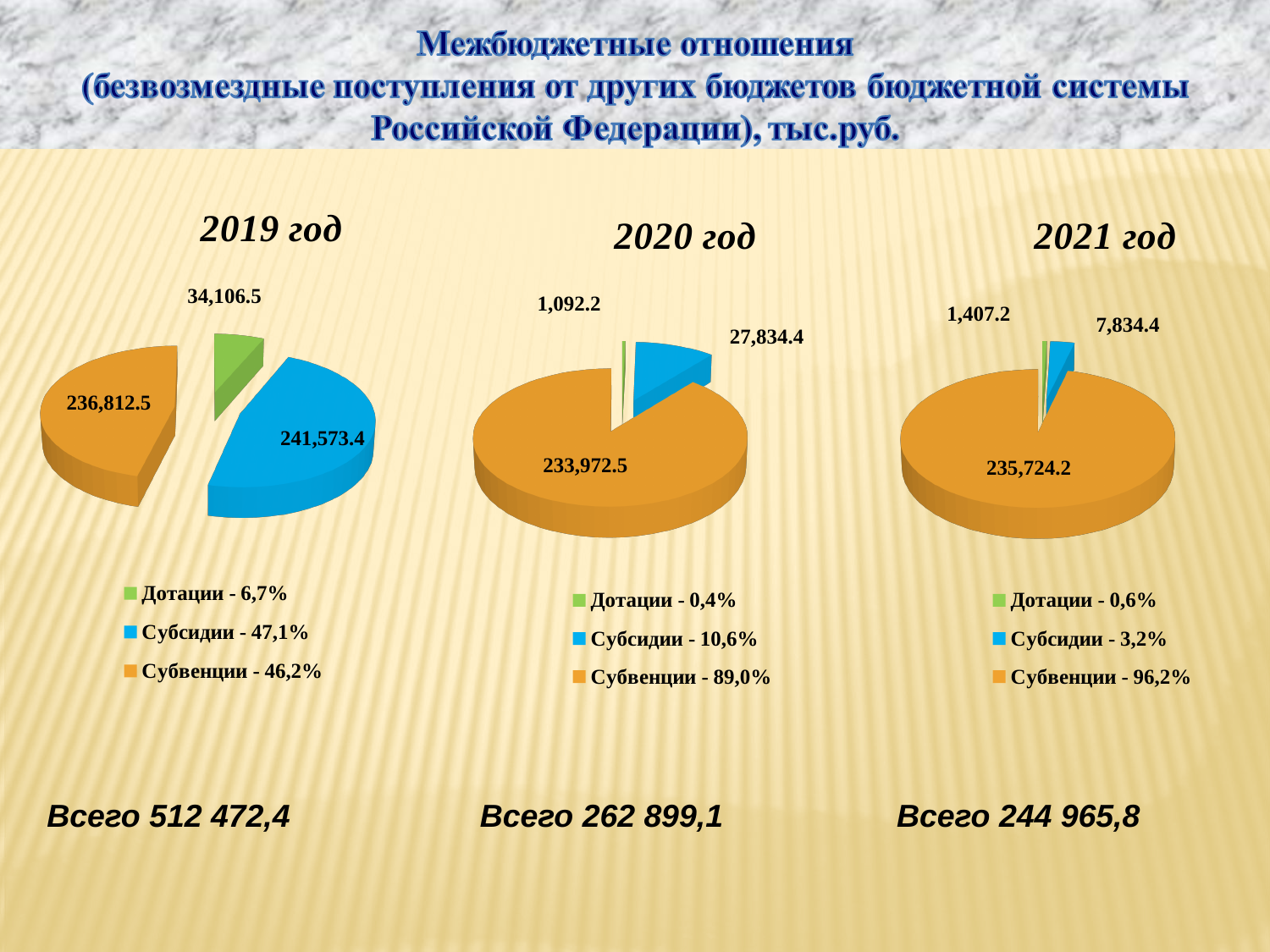
In the 2020 год chart, what share of the pie does Субвенции represent according to the legend? 89,0% In the 2021 год chart, which category has the smallest value? Дотации How many slices does the 2019 год pie chart have? 3 In the 2021 год chart, which is larger, Субсидии or Дотации? Субсидии What type of chart is used for the 2021 год data? Pie chart In the 2020 год chart, which category has the largest value? Субвенции In the 2019 год chart, which category has the smallest value? Дотации In the 2019 год chart, what is the value for Субсидии? 241,573.4 In the 2020 год chart, what is the value for Субвенции? 233,972.5 In the 2020 год chart, what is the difference between the values for Субсидии and Дотации? 26,742.2 In the 2019 год chart, what is the difference between the values for Субсидии and Субвенции? 4,760.9 In the 2021 год chart, what is the value for Дотации? 1,407.2